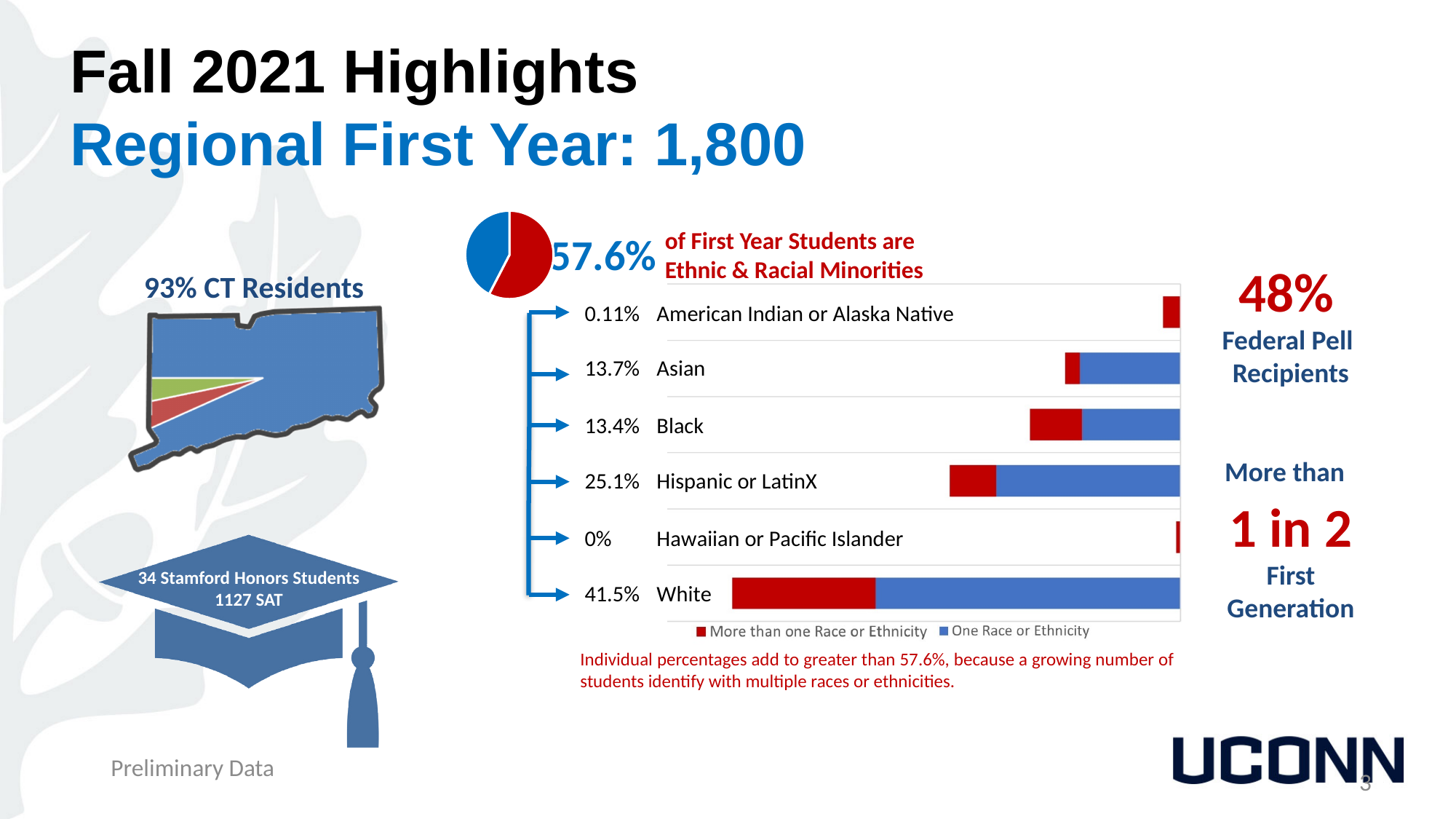
How many series does the legend of the race/ethnicity bar chart list? 2 In the race/ethnicity bar chart, which category has the lowest percentage? Hawaiian or Pacific Islander In the race/ethnicity bar chart, what percentage is shown for Hispanic or LatinX? 25.1% In the race/ethnicity bar chart, what percentage is shown for Asian? 13.7% In the race/ethnicity bar chart, what is the difference between the percentages for White and Hispanic or LatinX? 16.4% In the race/ethnicity bar chart, which category has the highest percentage? White In the race/ethnicity bar chart, what percentage is shown for American Indian or Alaska Native? 0.11% What kind of chart is used to show the race/ethnicity breakdown? Bar chart In the race/ethnicity bar chart, what percentage is shown for White? 41.5% How many race/ethnicity categories are shown in the bar chart? 6 According to the pie chart, what share of First Year Students are Ethnic & Racial Minorities? 57.6% In the race/ethnicity bar chart, which has the larger percentage, Asian or Black? Asian